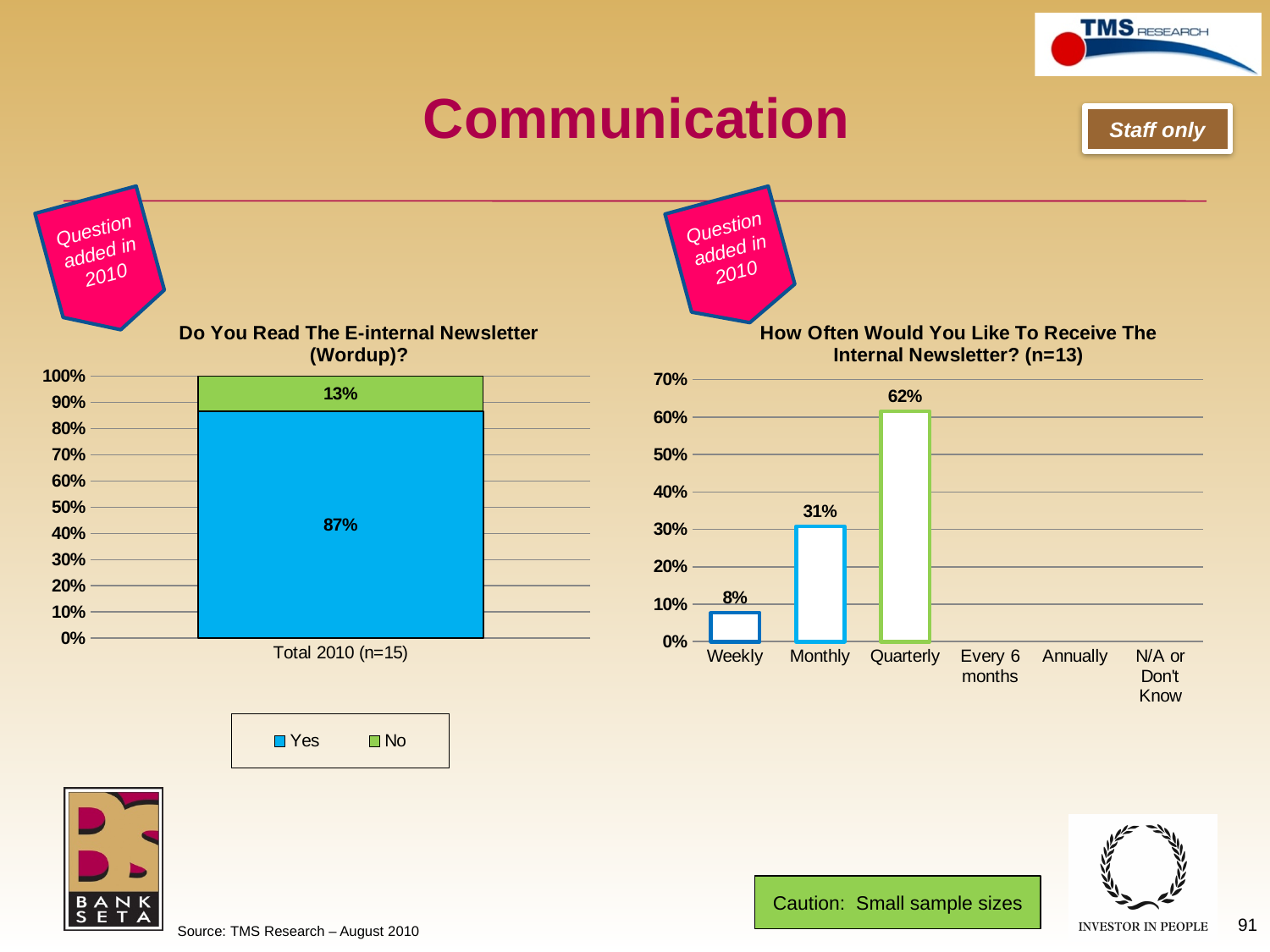
In the chart 'How Often Would You Like To Receive The Internal Newsletter?', what percentage chose Weekly? 8% In the chart 'Do You Read The E-internal Newsletter (Wordup)?', what percentage answered No? 13% In the chart 'Do You Read The E-internal Newsletter (Wordup)?', what is the label on the x axis under the bar? Total 2010 (n=15) What kind of chart is 'How Often Would You Like To Receive The Internal Newsletter?'? Bar chart In the chart 'How Often Would You Like To Receive The Internal Newsletter?', what percentage chose Quarterly? 62% In the chart 'How Often Would You Like To Receive The Internal Newsletter?', which is larger, Monthly or Weekly? Monthly In the chart 'Do You Read The E-internal Newsletter (Wordup)?', what is the difference between the Yes and No percentages? 74% In the chart 'How Often Would You Like To Receive The Internal Newsletter?', how many categories are shown on the x axis? 6 In the chart 'Do You Read The E-internal Newsletter (Wordup)?', how many series does the legend list? 2 In the chart 'How Often Would You Like To Receive The Internal Newsletter?', which category has the highest value? Quarterly In the chart 'Do You Read The E-internal Newsletter (Wordup)?', what percentage answered Yes? 87% In the chart 'How Often Would You Like To Receive The Internal Newsletter?', what is the difference between the Quarterly and Monthly percentages? 31%